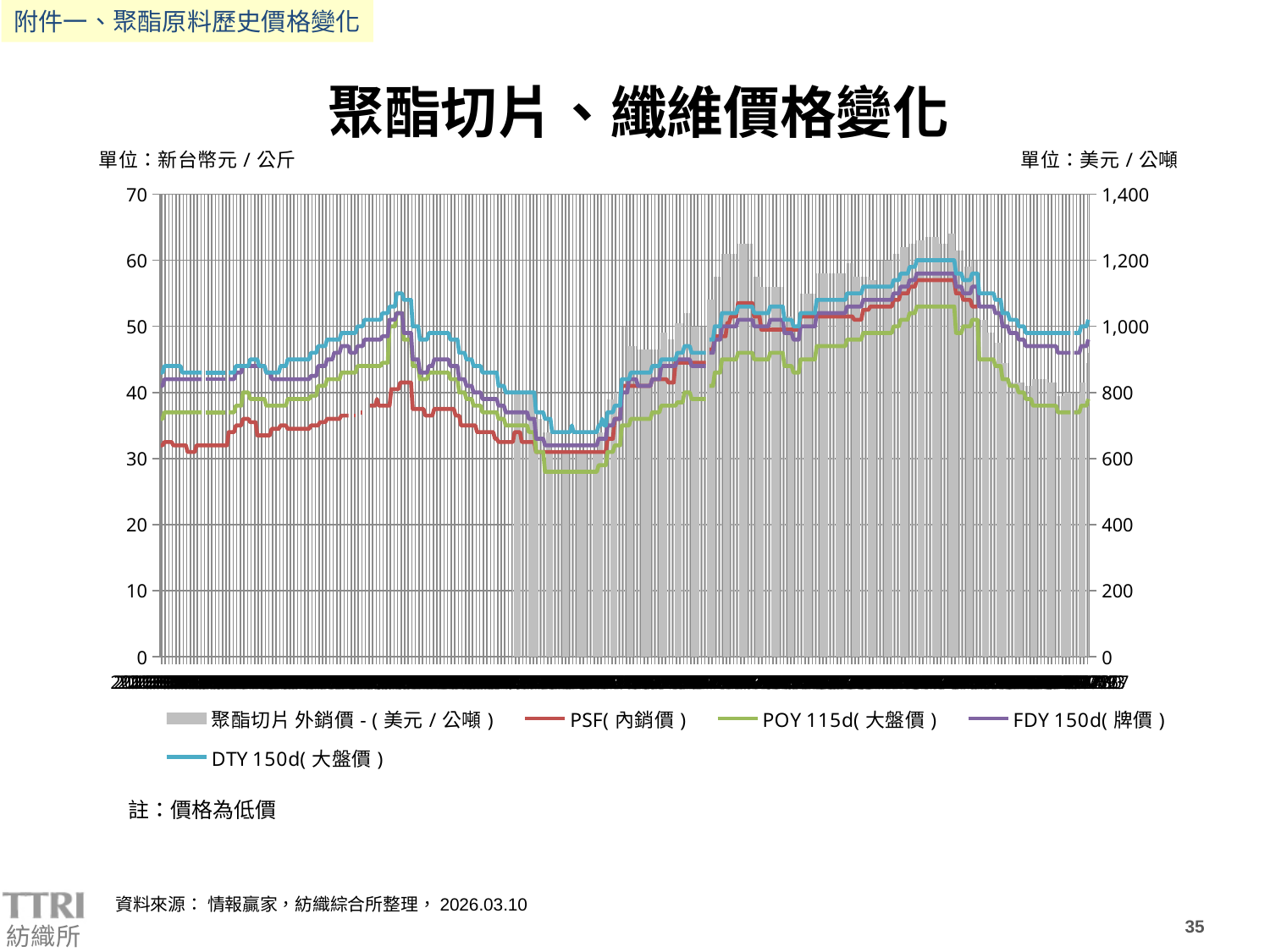
Is the tallest bar for 聚酯切片 外銷價 greater or less than 1,200 on the right axis? greater Is the highest value of the PSF( 內銷價 ) line greater or less than 60 on the left axis? less Which line series reaches the highest value on the left axis? DTY 150d( 大盤價 ) How many series does the legend list? 5 What kind of chart is shown on the slide? A combined bar and line chart Is the peak value of the DTY 150d( 大盤價 ) line greater or less than 50 on the left axis? greater Which line is higher throughout the chart, FDY 150d( 牌價 ) or POY 115d( 大盤價 )? FDY 150d( 牌價 ) Which line series drops to the lowest value on the left axis? POY 115d( 大盤價 ) What unit is shown for the left axis of the chart? 新台幣元 / 公斤 What is the title of the chart? 聚酯切片、纖維價格變化